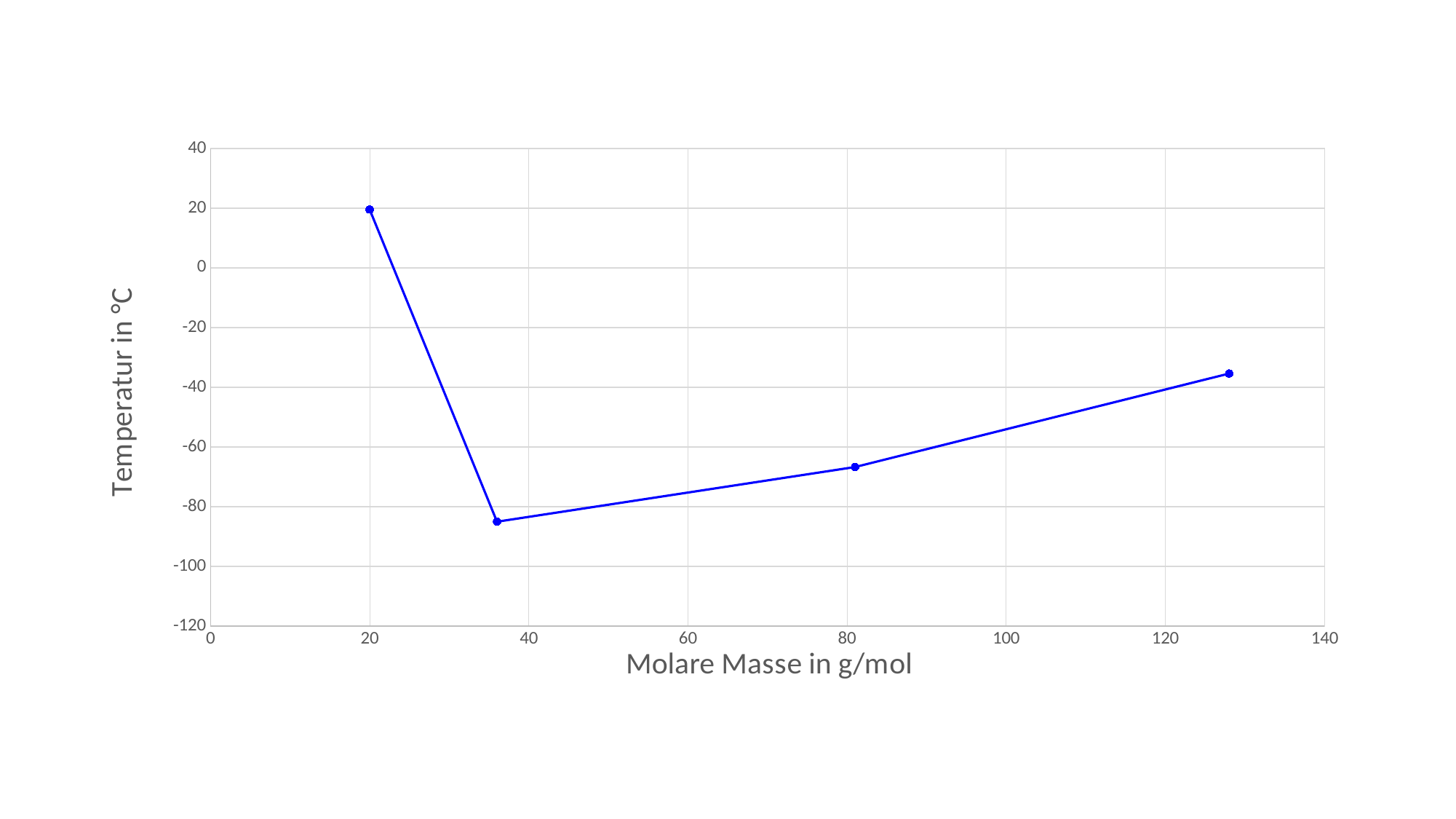
Does the temperature rise or fall between the first data point (about 20 g/mol) and the second data point (just below 40 g/mol)? fall What is the title of the horizontal axis? Molare Masse in g/mol What kind of chart is shown on the slide? line chart Is the temperature of the data point at about 20 g/mol greater or less than 0? greater Is the temperature of the data point at about 128 g/mol greater or less than -40? greater Is the temperature of the data point just below 40 g/mol greater or less than -80? less Which data point has the lowest temperature: the one at about 20 g/mol, just below 40 g/mol, about 80 g/mol, or about 128 g/mol? the one just below 40 g/mol How many data points are plotted on the chart? 4 What is the title of the vertical axis? Temperatur in °C Which has the higher temperature: the data point at about 80 g/mol or the one at about 128 g/mol? the one at about 128 g/mol Which data point has the highest temperature: the one at about 20 g/mol, just below 40 g/mol, about 80 g/mol, or about 128 g/mol? the one at about 20 g/mol